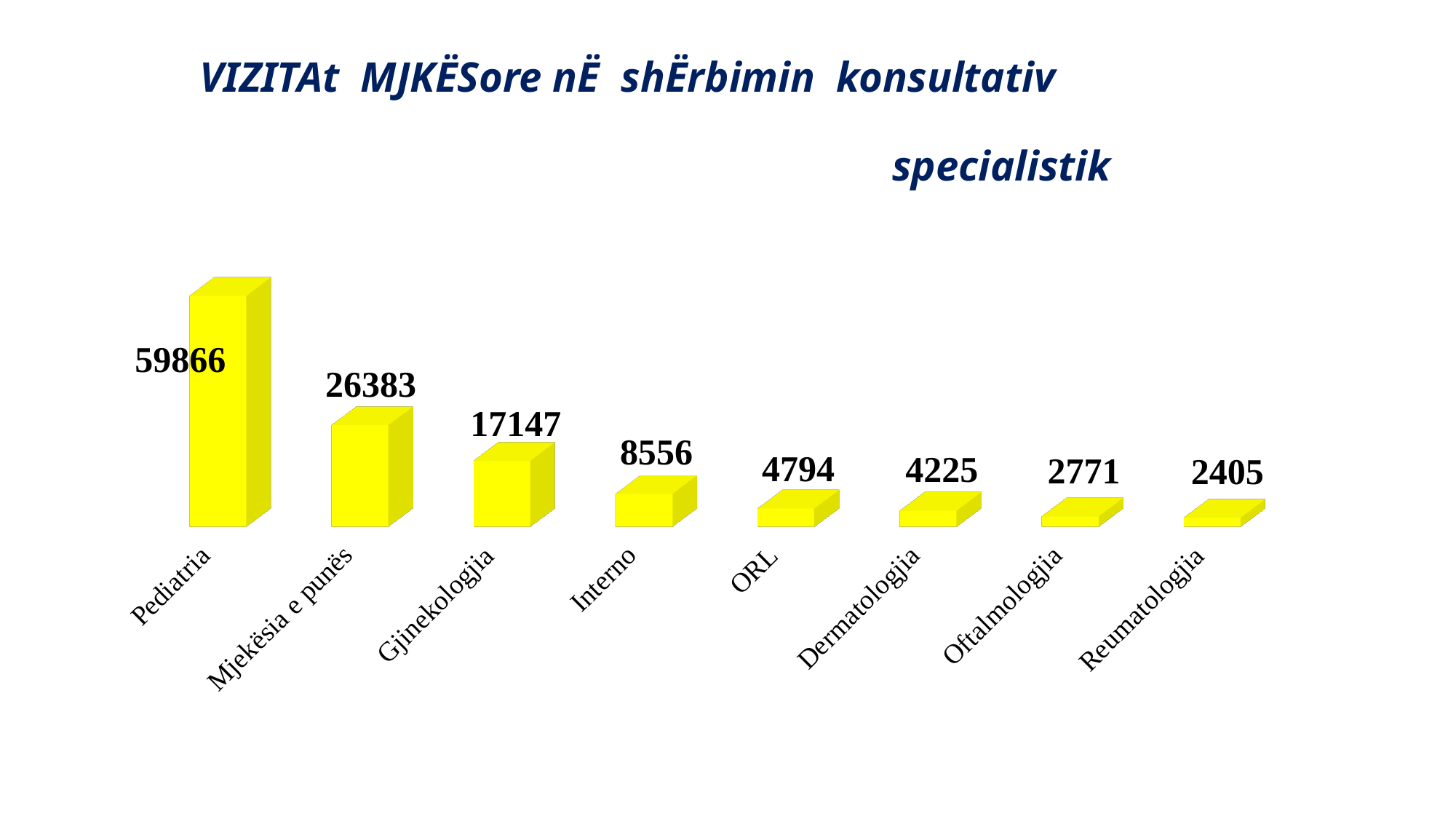
What is the value for Pediatria? 59866 What is the value for Gjinekologjia? 17147 Which category has the lowest value? Reumatologjia What is the value for ORL? 4794 Which category has the highest value? Pediatria How many categories are shown in the chart? 8 What is the value for Reumatologjia? 2405 What is the value for Interno? 8556 What kind of chart is shown on the slide? bar chart What is the difference between the values for Pediatria and Mjekësia e punës? 33483 What is the value for Mjekësia e punës? 26383 Which is larger, the value for Dermatologjia or the value for Oftalmologjia? Dermatologjia